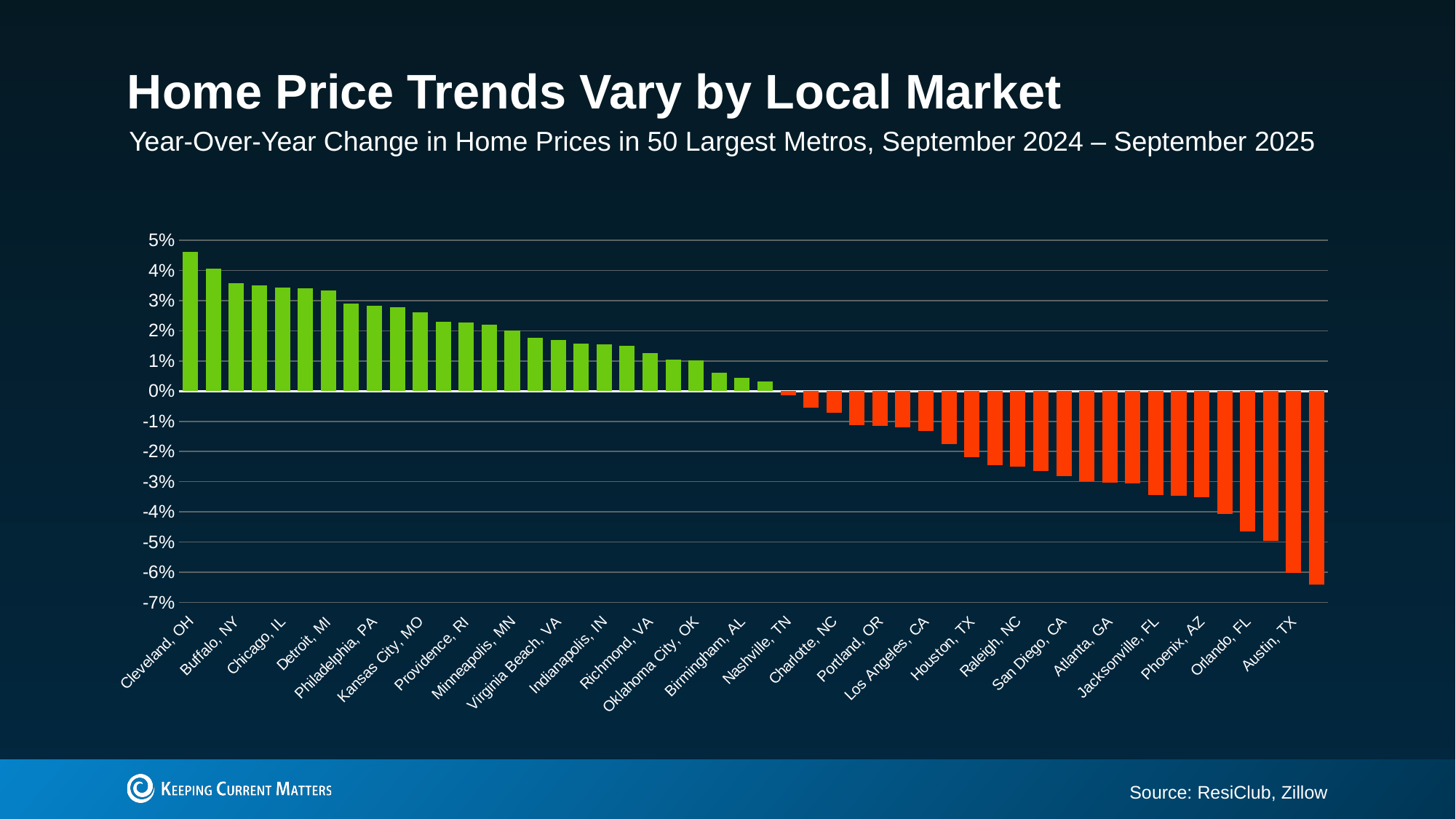
Which metro has the highest year-over-year change in home prices? Cleveland, OH Is the value for Orlando, FL greater or less than -4%? less How many metros does the chart cover? 50 What colour are the bars for metros with negative year-over-year changes? Red Is the value for Houston, TX greater or less than -1%? less Which has the larger year-over-year change, Cleveland, OH or Austin, TX? Cleveland, OH What kind of chart is shown on the slide? Bar chart Is the value for Austin, TX greater or less than -5%? less Do the values rise or fall moving from left to right along the x axis? Fall